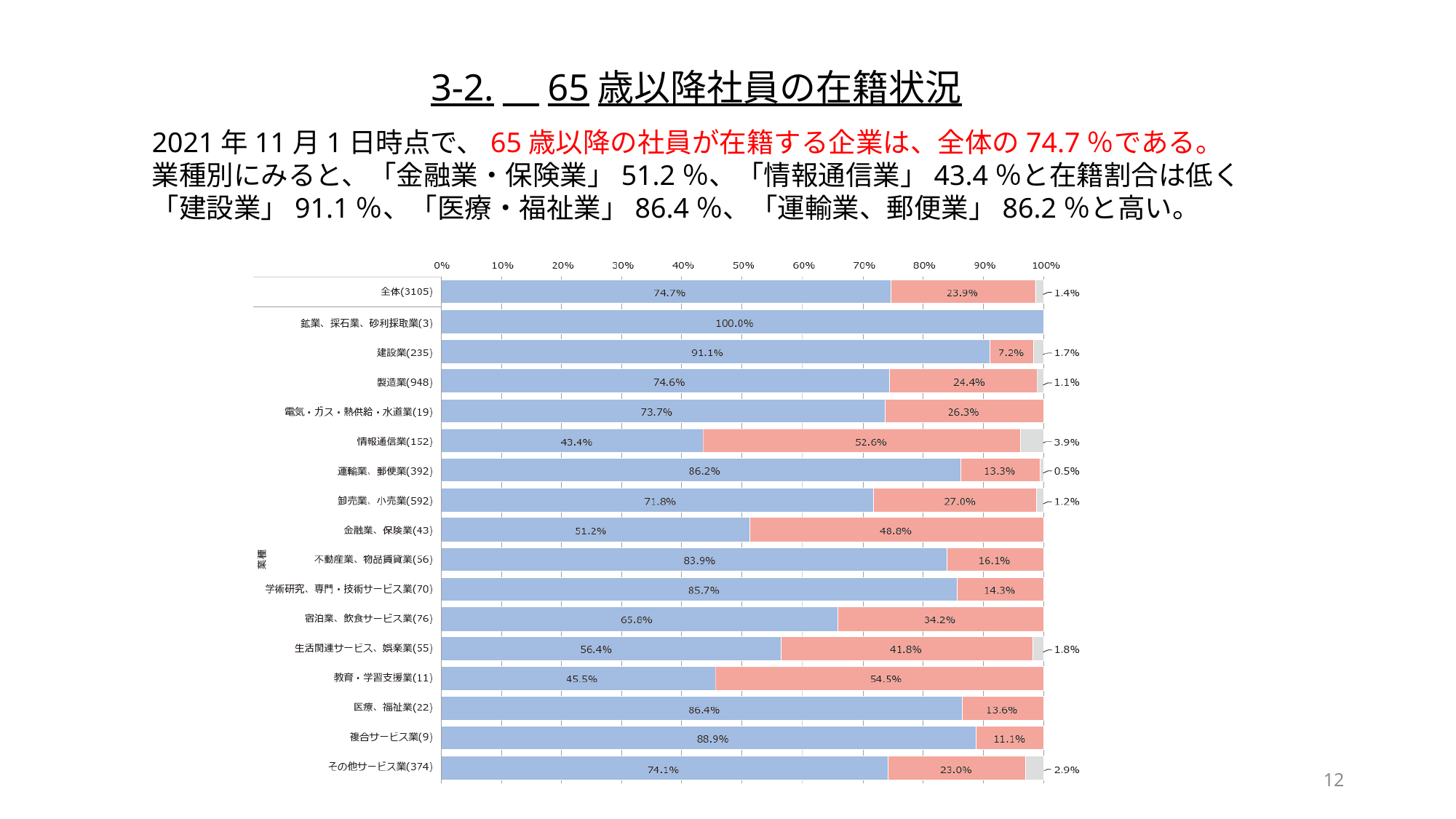
What is the maximum value shown on the horizontal axis? 100% What is the value of the grey (third) segment for その他サービス業(374)? 2.9% What is the value of the grey (third) segment for 運輸業、郵便業(392)? 0.5% Which category has the largest blue (first) segment? 鉱業、採石業、砂利採取業(3) What is the value of the red (second) segment for 情報通信業(152)? 52.6% Which has a larger blue segment value, 医療、福祉業(22) or 運輸業、郵便業(392)? 医療、福祉業(22) What type of chart is shown on the slide? Stacked horizontal bar chart Which category has the smallest blue (first) segment? 情報通信業(152) What is the value of the blue (first) segment for 全体(3105)? 74.7% What is the difference between the blue segment values of 建設業(235) and 製造業(948)? 16.5% What is the value of the red (second) segment for 金融業、保険業(43)? 48.8% How many categories (bars) are shown in the chart? 17